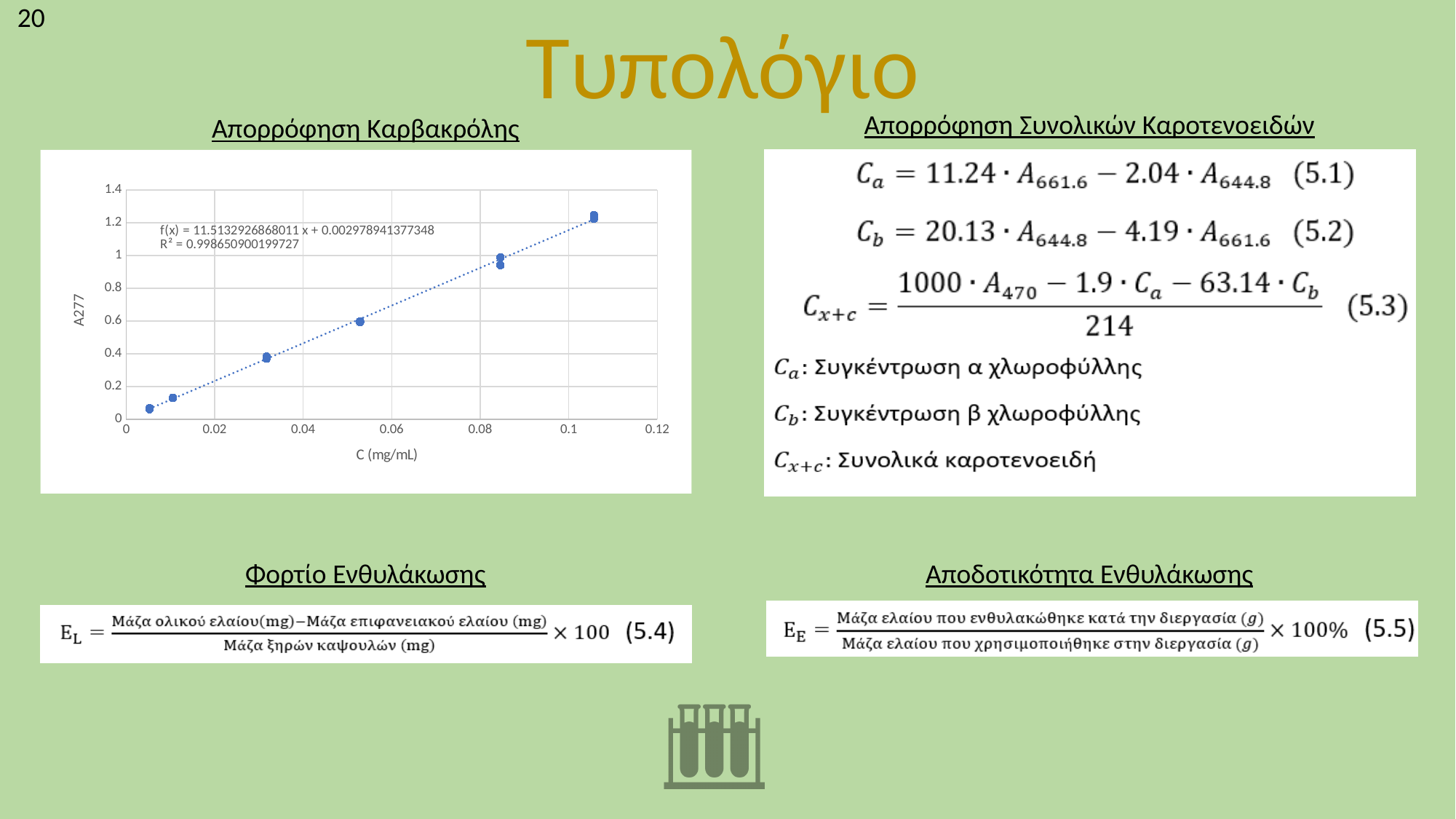
In the 'Απορρόφηση Καρβακρόλης' chart, are the A277 values of the points at about C = 0.105 mg/mL greater or less than 1? greater What kind of chart is shown under the heading 'Απορρόφηση Καρβακρόλης'? Scatter chart What R² value is printed on the 'Απορρόφηση Καρβακρόλης' chart? 0.998650900199727 In the 'Απορρόφηση Καρβακρόλης' chart, which has the higher A277: the point at about C = 0.053 mg/mL or the points at about C = 0.084 mg/mL? The points at about C = 0.084 mg/mL In the 'Απορρόφηση Καρβακρόλης' chart, at which C value is the highest A277 observed: the smallest C or the largest C plotted? The largest C plotted In the 'Απορρόφηση Καρβακρόλης' chart, is the A277 value of the point at about C = 0.053 mg/mL greater or less than 0.8? less In the 'Απορρόφηση Καρβακρόλης' chart, is the A277 value of the point at about C = 0.01 mg/mL greater or less than 0.2? less What is the label of the x axis in the 'Απορρόφηση Καρβακρόλης' chart? C (mg/mL) In the 'Απορρόφηση Καρβακρόλης' chart, does A277 rise or fall as C (mg/mL) increases? Rises